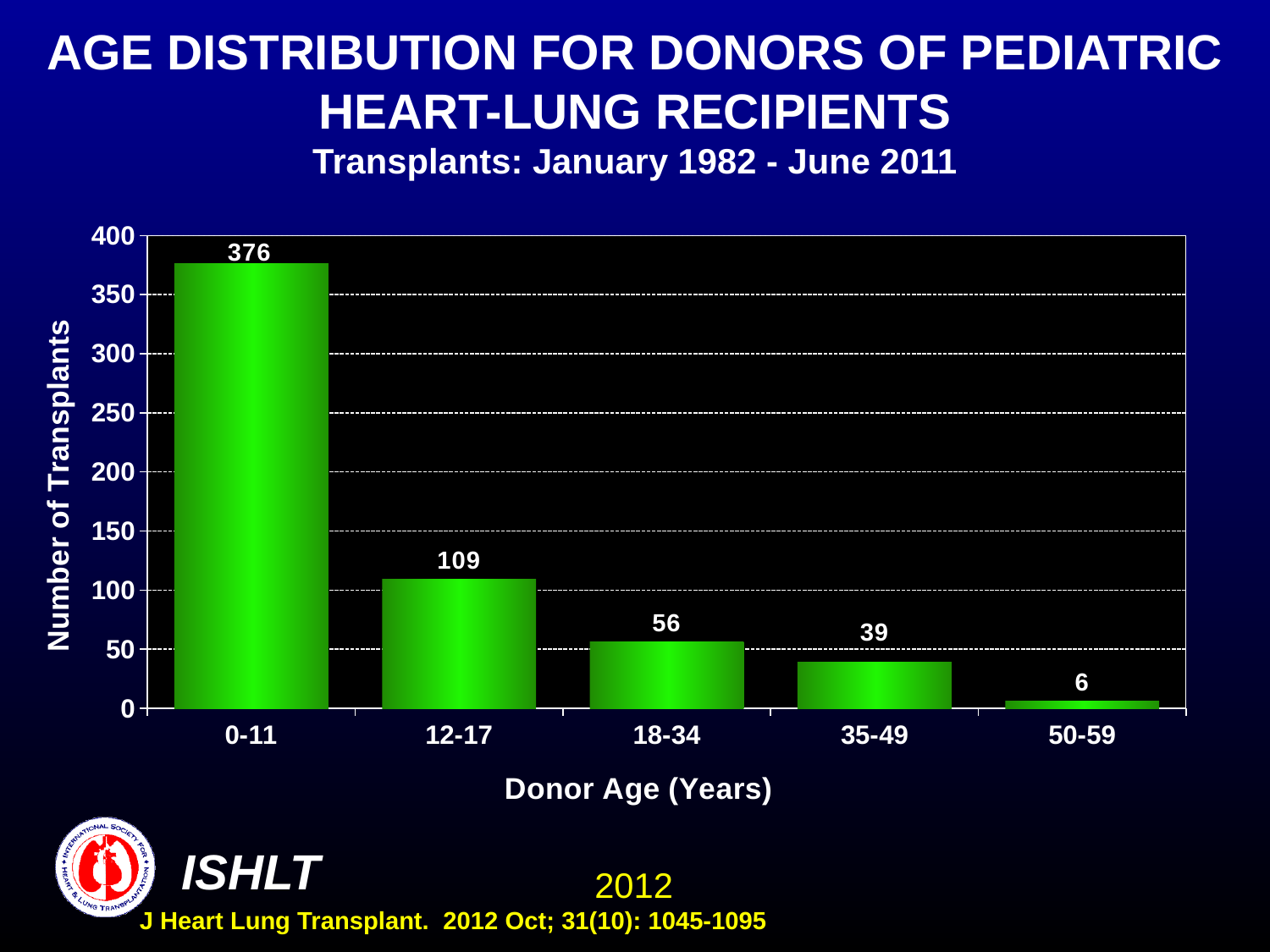
Do the values rise or fall as donor age increases along the x axis? fall What is the number of transplants for donor age 0-11? 376 What is the number of transplants for donor age 12-17? 109 What is the difference in number of transplants between the 18-34 and 35-49 donor age groups? 17 Which donor age group has the lowest number of transplants? 50-59 Which donor age group has the highest number of transplants? 0-11 Which donor age group has more transplants, 18-34 or 35-49? 18-34 What is the difference in number of transplants between the 0-11 and 12-17 donor age groups? 267 How many donor age groups are shown on the x axis? 5 Is the value for donor age 12-17 greater or less than 100? greater What kind of chart is shown on the slide? bar chart What is the number of transplants for donor age 50-59? 6